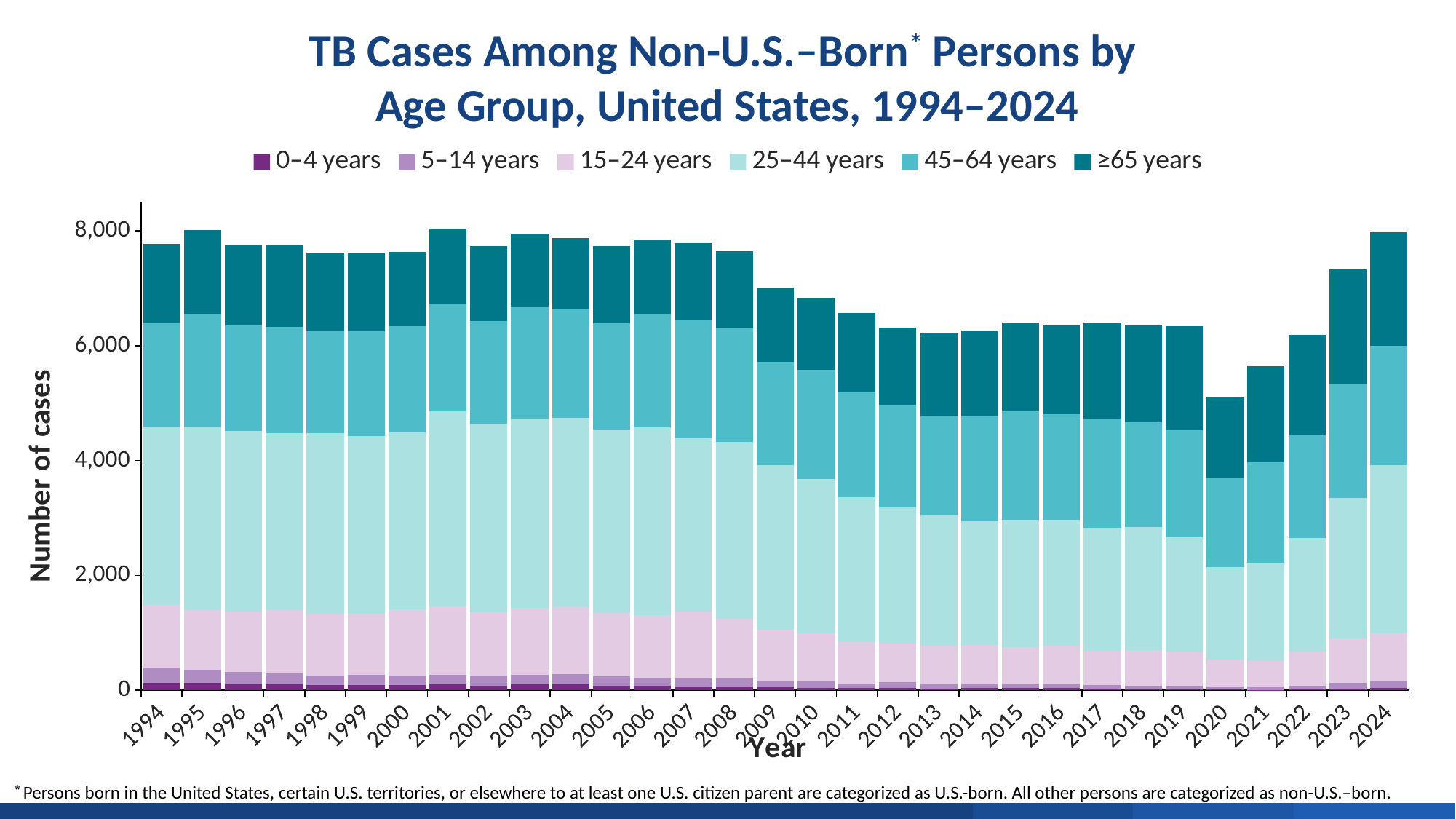
Do the total number of cases rise or fall from 2020 to 2024? rise What kind of chart is shown on the slide? Stacked bar chart Is the total number of cases in 2023 greater or less than 8,000? less Which year has a higher total number of cases, 2008 or 2009? 2008 Which year has a higher total number of cases, 2020 or 2021? 2021 Is the total number of cases in 2009 greater or less than 6,000? greater Which age group is listed first in the legend? 0–4 years Is the total number of cases in 2020 greater or less than 6,000? less Which year has the lowest total number of TB cases among non-U.S.-born persons? 2020 How many age-group series does the legend list? 6 How many years are plotted along the x axis? 31